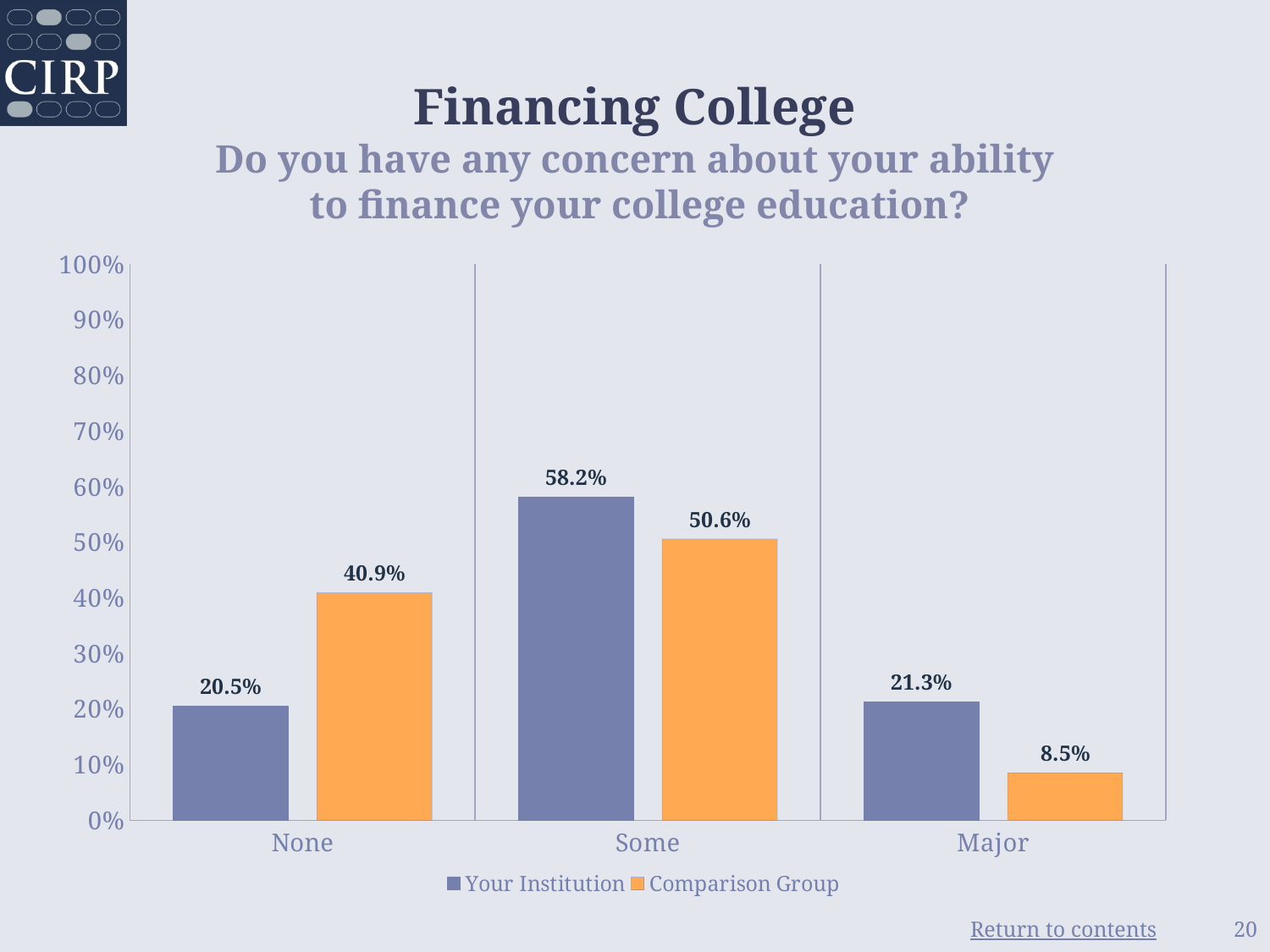
What kind of chart is shown on the slide? bar chart What is the value for Comparison Group in the Some category? 50.6% Which category has the lowest value for Comparison Group? Major Is the value for Comparison Group in the None category greater or less than 50%? less What is the value for Your Institution in the None category? 20.5% What is the difference between Your Institution and Comparison Group in the None category? 20.4% What is the difference between Your Institution and Comparison Group in the Major category? 12.8% How many series does the legend list? 2 Which category has the highest value for Your Institution? Some In the Some category, which is larger: Your Institution or Comparison Group? Your Institution What is the value for Comparison Group in the Major category? 8.5% How many categories are shown on the x axis? 3